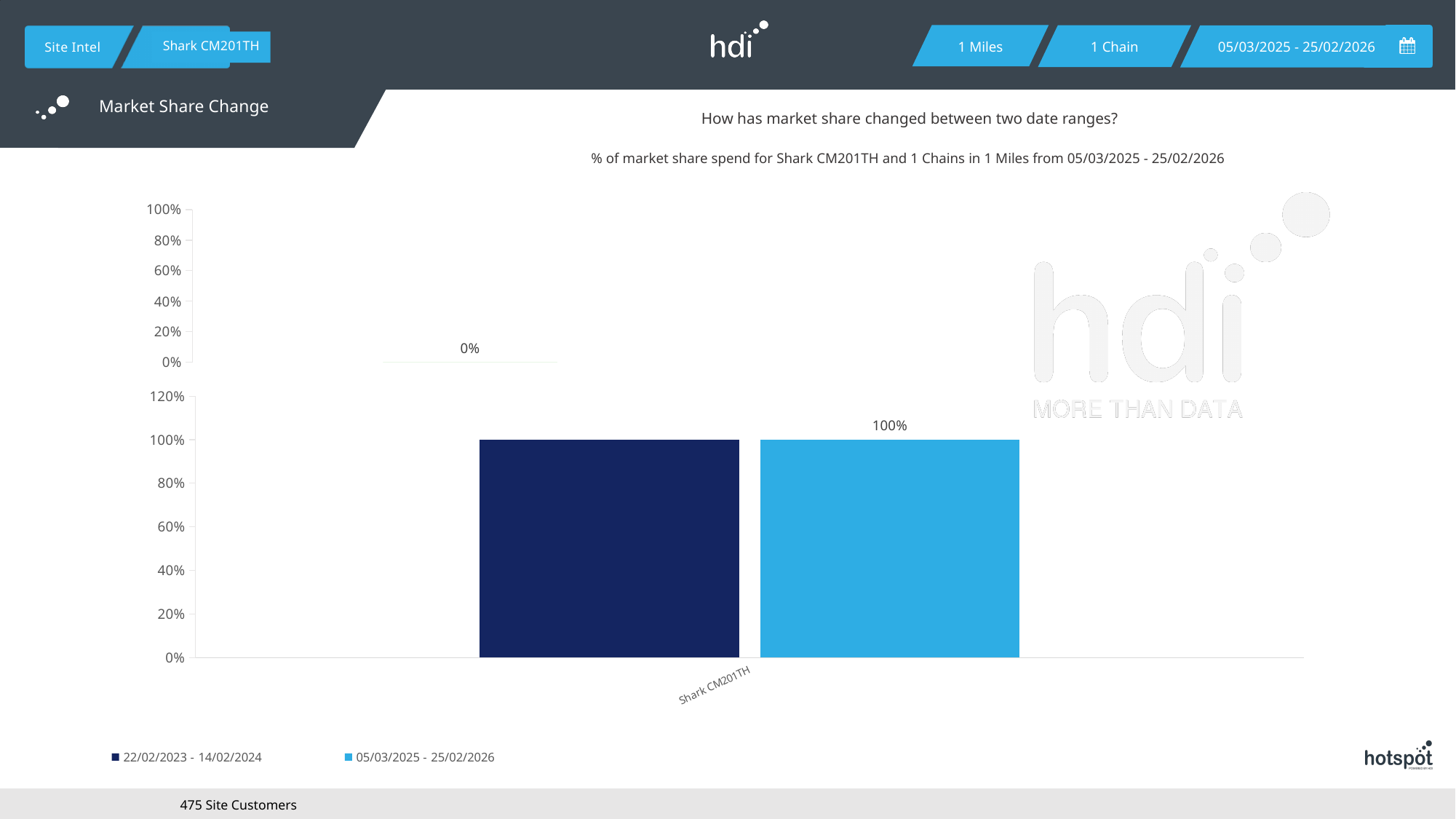
What is the highest tick on the y axis of the bottom chart? 120% In the bottom chart, what value does the 22/02/2023 - 14/02/2024 bar for Shark CM201TH reach? 100% How many categories are shown on the x axis of the bottom chart? 1 What is the category label on the x axis of the bottom chart? Shark CM201TH What kind of chart is the bottom chart? bar chart What value is labelled on the top chart? 0% In the bottom chart, what is the value of the 05/03/2025 - 25/02/2026 bar for Shark CM201TH? 100% In the bottom chart, is the value for Shark CM201TH in 05/03/2025 - 25/02/2026 greater or less than 80%? greater In the bottom chart, is the value for Shark CM201TH in 22/02/2023 - 14/02/2024 greater or less than 120%? less Which legend entry in the bottom chart is shown in dark navy? 22/02/2023 - 14/02/2024 How many series does the legend of the bottom chart list? 2 What is the difference between the two bars for Shark CM201TH in the bottom chart? 0%